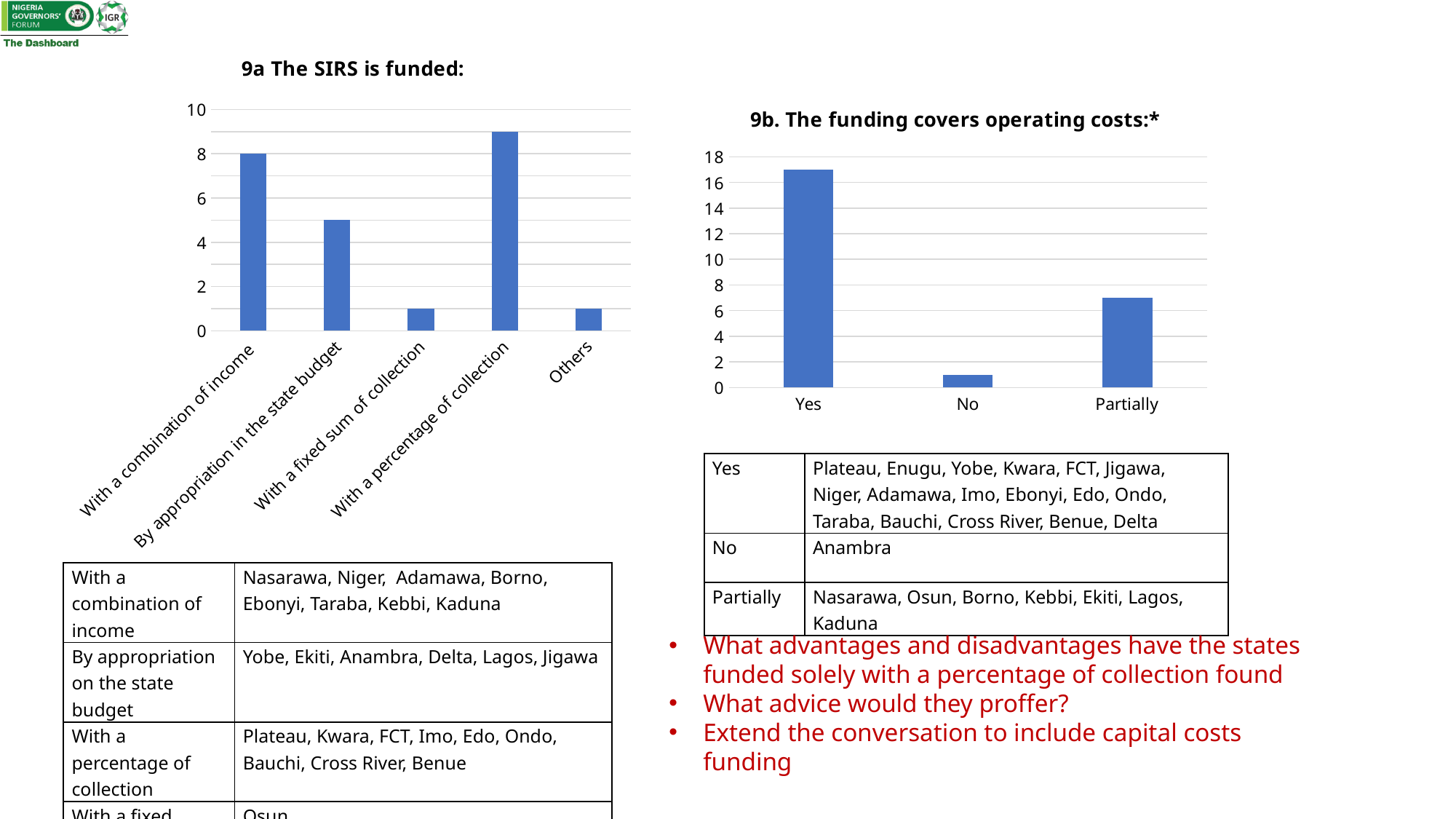
In the chart "9a The SIRS is funded:", which is larger: "With a combination of income" or "By appropriation in the state budget"? With a combination of income In the chart "9b. The funding covers operating costs:*", is the value for "Partially" greater or less than 8? less In the chart "9b. The funding covers operating costs:*", is the value for "Yes" greater or less than 16? greater What is the title of the chart on the right side of the slide? 9b. The funding covers operating costs:* In the chart "9b. The funding covers operating costs:*", which category has the lowest value? No In the chart "9a The SIRS is funded:", is the value for "By appropriation in the state budget" greater or less than 4? greater In the chart "9a The SIRS is funded:", which category has the highest value? With a percentage of collection What kind of chart is "9a The SIRS is funded:"? bar chart In the chart "9b. The funding covers operating costs:*", which category has the highest value? Yes In the chart "9b. The funding covers operating costs:*", how many categories are shown on the x axis? 3 In the chart "9a The SIRS is funded:", what is the value for "With a combination of income"? 8 In the chart "9a The SIRS is funded:", how many categories are shown on the x axis? 5